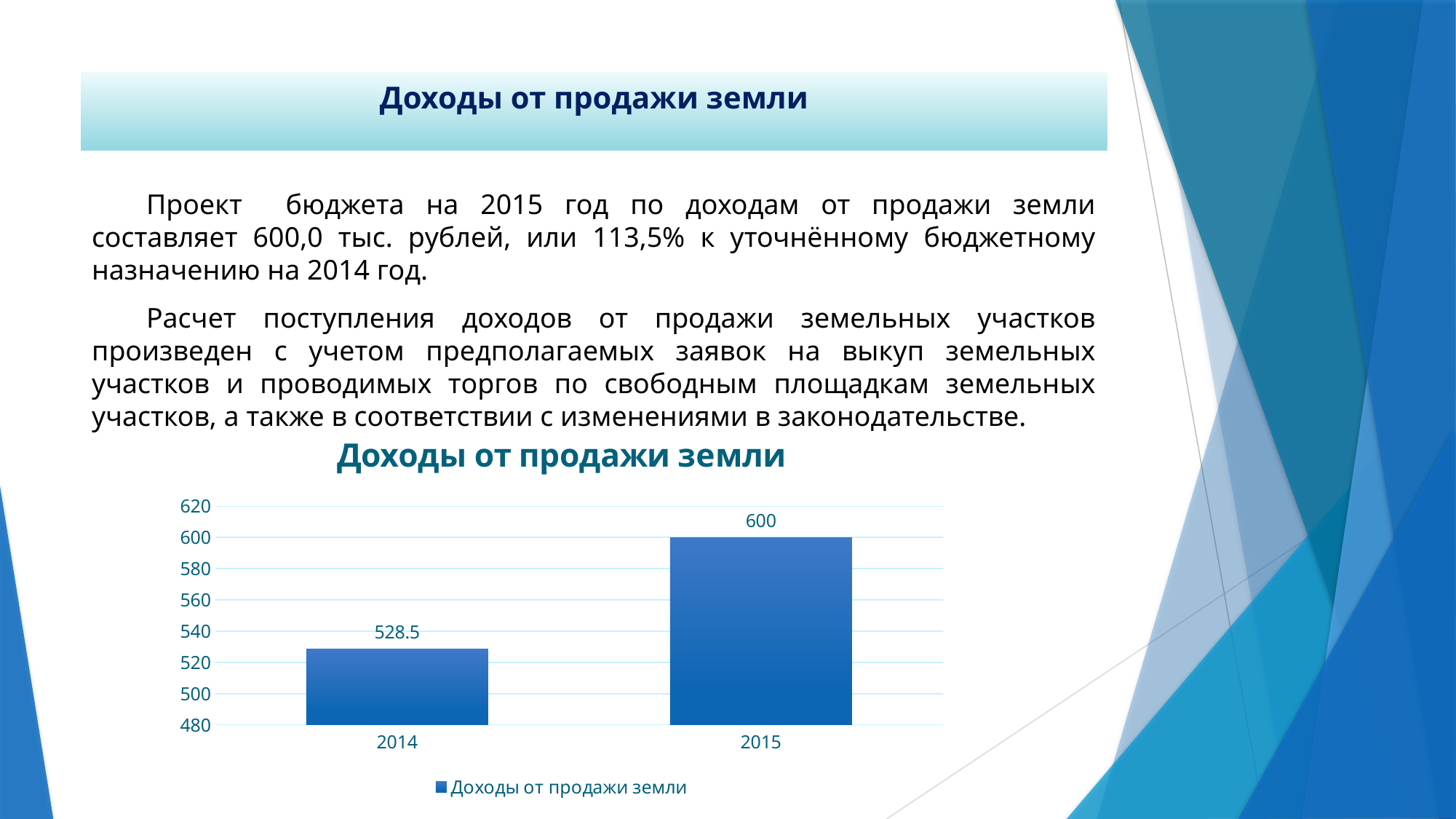
What is the value for 2014 in the chart? 528.5 How many categories are shown on the x axis of the chart? 2 Do the values rise or fall from 2014 to 2015? rise What is the value for 2015 in the chart? 600 Is the value for 2014 greater or less than 540? less Which is larger, the value for 2014 or the value for 2015? 2015 What kind of chart is shown on the slide? bar chart Which year has the highest value in the chart? 2015 How many series does the chart legend list? 1 Which year has the lowest value in the chart? 2014 What is the difference between the values for 2015 and 2014? 71.5 What is the title of the chart? Доходы от продажи земли